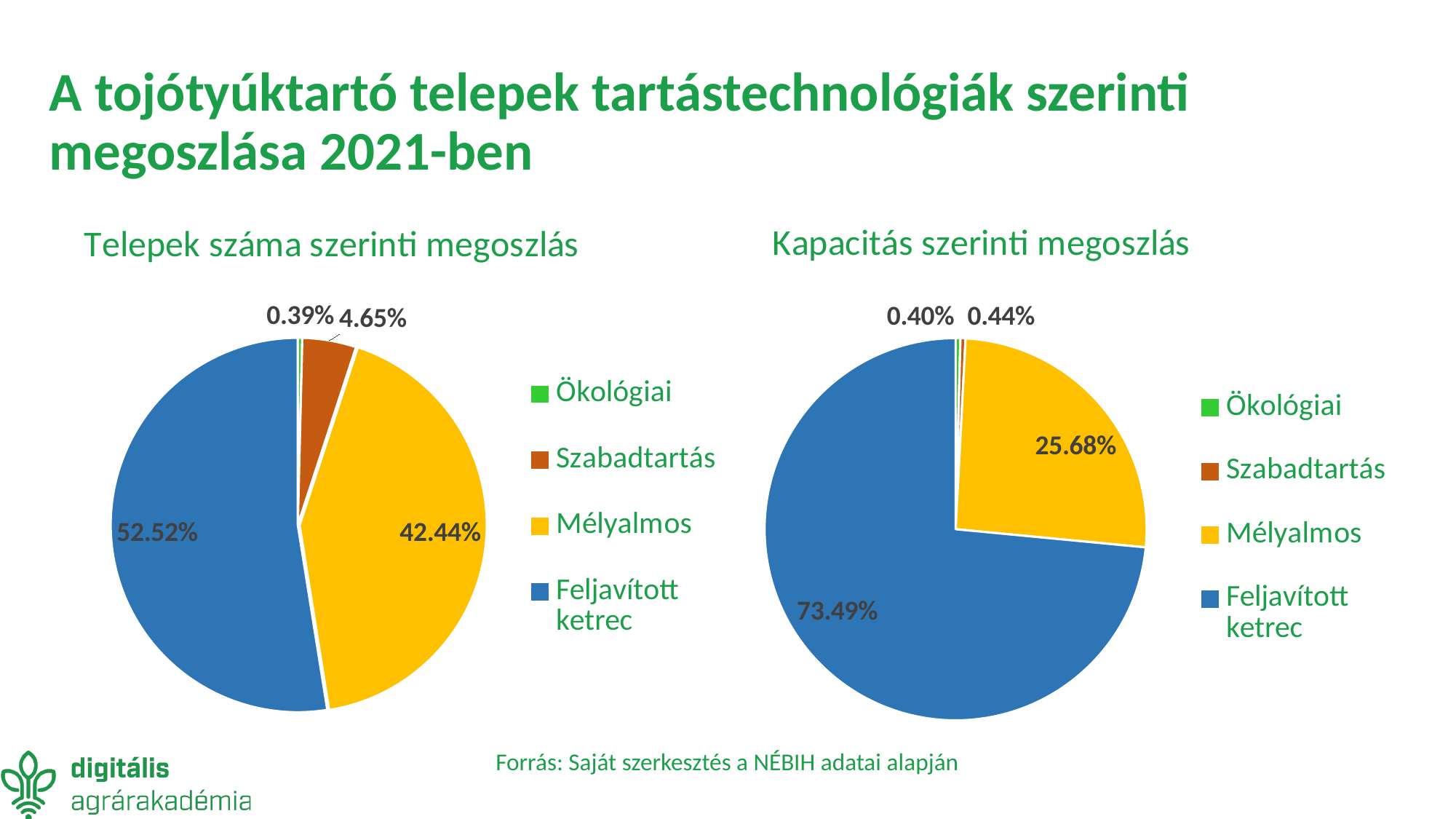
In the 'Kapacitás szerinti megoszlás' pie chart, what share does Feljavított ketrec have? 73.49% In the 'Telepek száma szerinti megoszlás' pie chart, what share does Szabadtartás have? 4.65% In the 'Telepek száma szerinti megoszlás' pie chart, what is the difference between the Feljavított ketrec and Mélyalmos shares? 10.08% In the 'Telepek száma szerinti megoszlás' pie chart, which category has the smallest slice? Ökológiai In the 'Telepek száma szerinti megoszlás' pie chart, what share does Mélyalmos have? 42.44% What type of chart is used for 'Kapacitás szerinti megoszlás'? Pie chart In the 'Kapacitás szerinti megoszlás' pie chart, which category has the largest slice? Feljavított ketrec In the 'Kapacitás szerinti megoszlás' pie chart, what colour is the Mélyalmos slice? Yellow How many categories does the legend of the 'Telepek száma szerinti megoszlás' chart list? 4 In the 'Telepek száma szerinti megoszlás' pie chart, what share does Feljavított ketrec have? 52.52% In the 'Kapacitás szerinti megoszlás' pie chart, which is larger: Mélyalmos or Feljavított ketrec? Feljavított ketrec In the 'Kapacitás szerinti megoszlás' pie chart, what share does Mélyalmos have? 25.68%